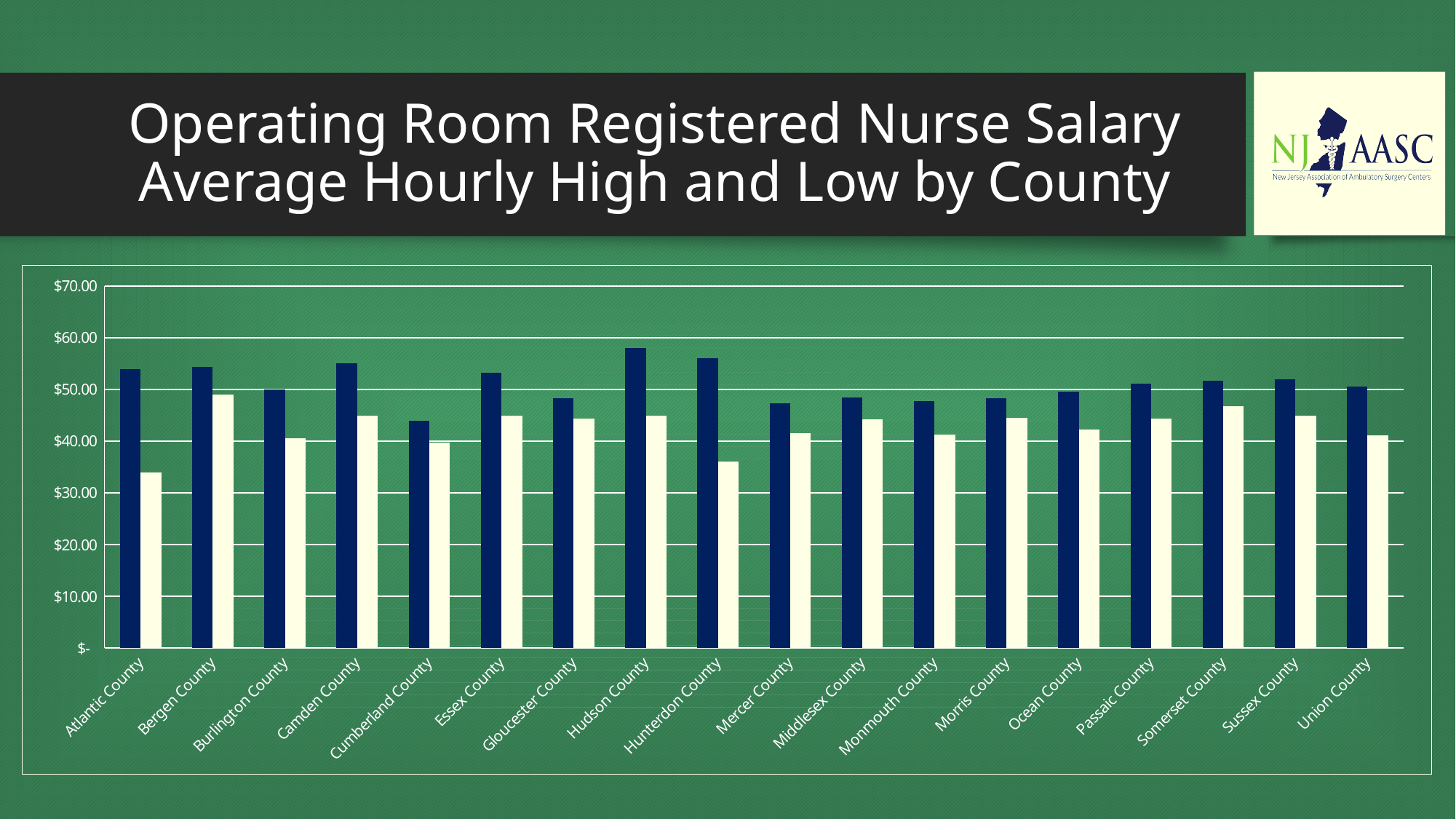
How many counties are shown along the x axis of the chart? 18 What kind of chart is shown on the slide? Bar chart Which county has the shortest cream-coloured bar in the chart? Atlantic County Which county has the tallest cream-coloured bar in the chart? Bergen County Is the dark blue bar for Hudson County greater or less than $50.00? greater Which is larger: the dark blue bar for Atlantic County or the dark blue bar for Cumberland County? Atlantic County Which county has the tallest dark blue bar in the chart? Hudson County Is the cream-coloured bar for Atlantic County greater or less than $40.00? less How many bars are plotted for each county in the chart? 2 Is the dark blue bar for Cumberland County greater or less than $50.00? less What is the title of the slide containing the chart? Operating Room Registered Nurse Salary Average Hourly High and Low by County Which county has the shortest dark blue bar in the chart? Cumberland County